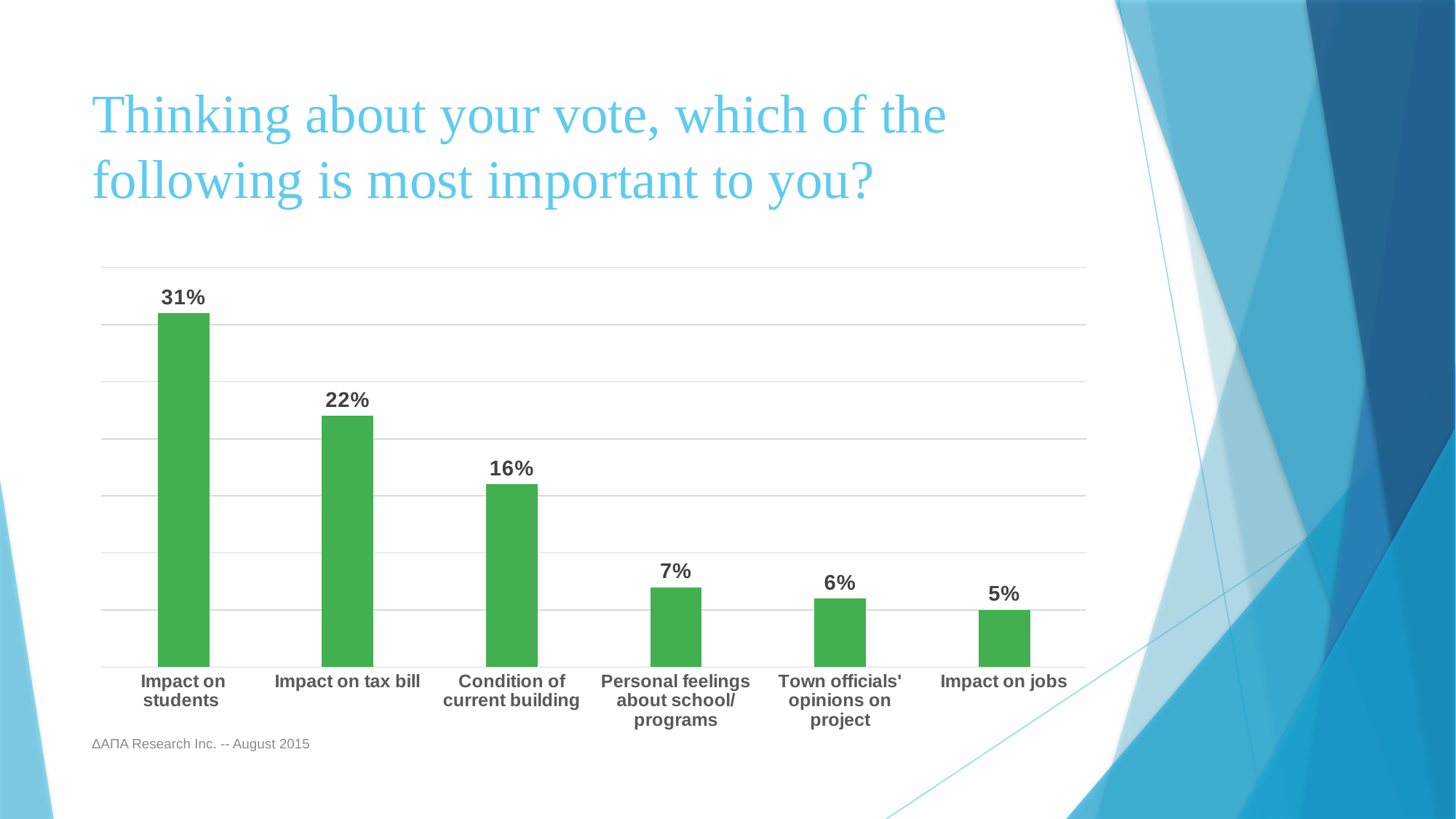
What kind of chart is shown on the slide? Bar chart Which category has the lowest value? Impact on jobs What percentage of respondents chose "Impact on students" as most important? 31% Do the values rise or fall from left to right across the categories? Fall What is the difference between "Condition of current building" and "Personal feelings about school/programs"? 9% What percentage is shown for "Condition of current building"? 16% What is the difference between the values for "Impact on students" and "Impact on tax bill"? 9% How many categories are shown in the chart? 6 What is the value shown for "Impact on tax bill"? 22% Which category has the highest value? Impact on students Which is larger: the value for "Impact on tax bill" or the value for "Condition of current building"? Impact on tax bill What is the value for "Town officials' opinions on project"? 6%